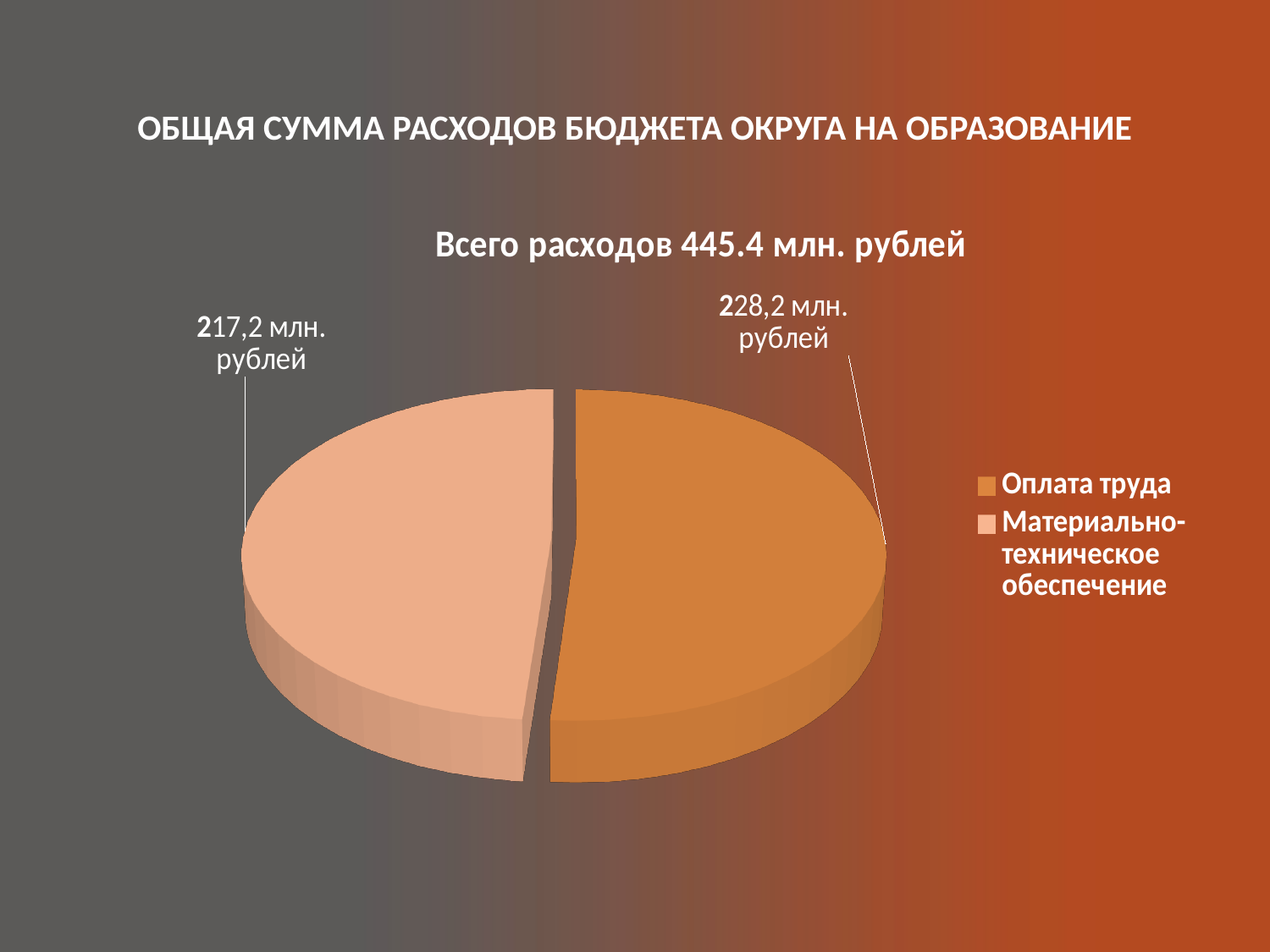
What total expenditure is stated in the chart title? 445.4 млн. рублей What is the value for Оплата труда? 228,2 млн. рублей What is the chart's title? Всего расходов 445.4 млн. рублей What kind of chart is shown on the slide? Pie chart How many entries does the legend list? 2 How many slices does the pie chart have? 2 Which category has the largest slice of the pie? Оплата труда Which category has the smallest slice of the pie? Материально-техническое обеспечение What is the difference between Оплата труда and Материально-техническое обеспечение? 11,0 млн. рублей What is the value for Материально-техническое обеспечение? 217,2 млн. рублей Which is larger: Оплата труда or Материально-техническое обеспечение? Оплата труда Which legend entry is shown in the lighter peach colour? Материально-техническое обеспечение